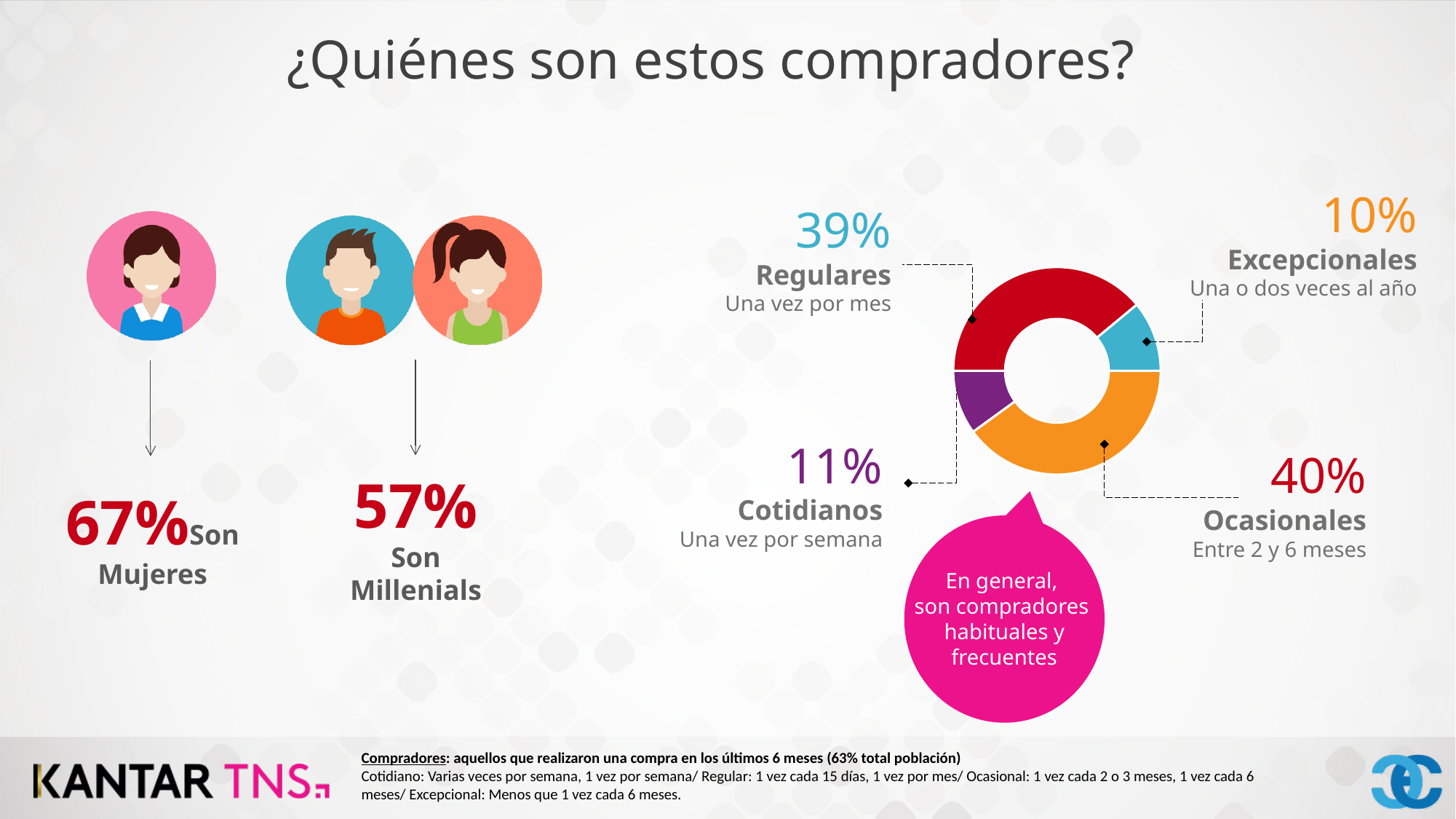
Which is larger in the donut chart, Cotidianos or Excepcionales? Cotidianos What kind of chart is used to show the buyer frequency categories? Donut (pie) chart Which buyer category has the smallest share in the donut chart? Excepcionales What is the combined share of Regulares and Ocasionales in the donut chart? 79% What percentage of buyers are Excepcionales in the donut chart? 10% How many buyer categories are shown in the donut chart? 4 What is the difference in percentage points between Regulares and Excepcionales in the donut chart? 29 What percentage of buyers are Ocasionales in the donut chart? 40% What percentage of buyers are Regulares in the donut chart? 39% What is the difference in percentage points between Ocasionales and Cotidianos in the donut chart? 29 Which buyer category has the largest share in the donut chart? Ocasionales What percentage of buyers are Cotidianos in the donut chart? 11%